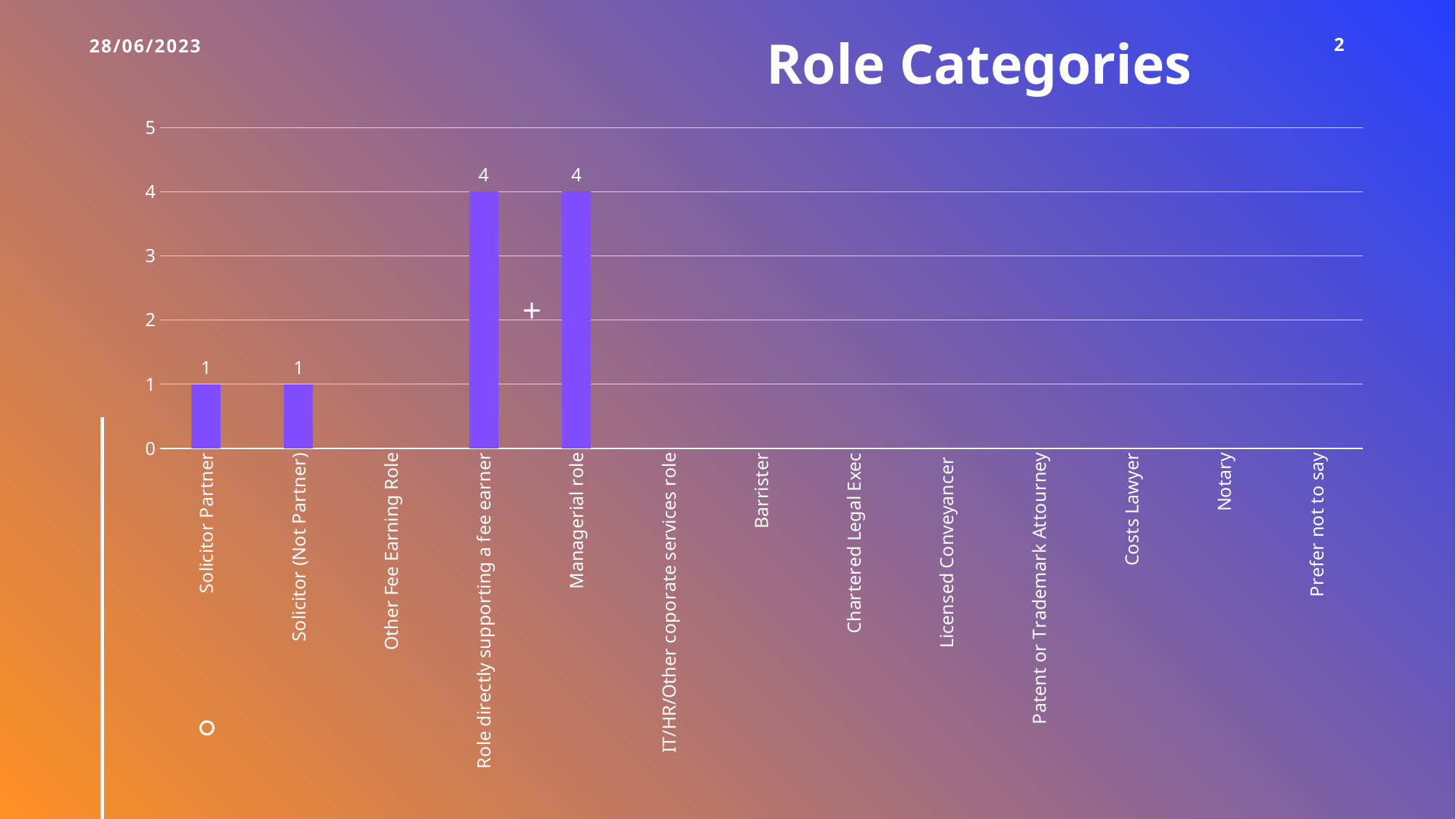
What kind of chart is shown on the slide? bar chart Which is larger, the value for Role directly supporting a fee earner or the value for Solicitor (Not Partner)? Role directly supporting a fee earner What is the difference between the values for Managerial role and Solicitor Partner? 3 What is the value for Solicitor (Not Partner)? 1 What is the value for Managerial role? 4 What is the title of the chart? Role Categories How many categories are shown on the x axis? 13 Is the value for Managerial role greater or less than 3? greater What is the value for Solicitor Partner? 1 Is the value for Solicitor Partner greater or less than 2? less What is the value for Role directly supporting a fee earner? 4 How many categories have a visible bar? 4